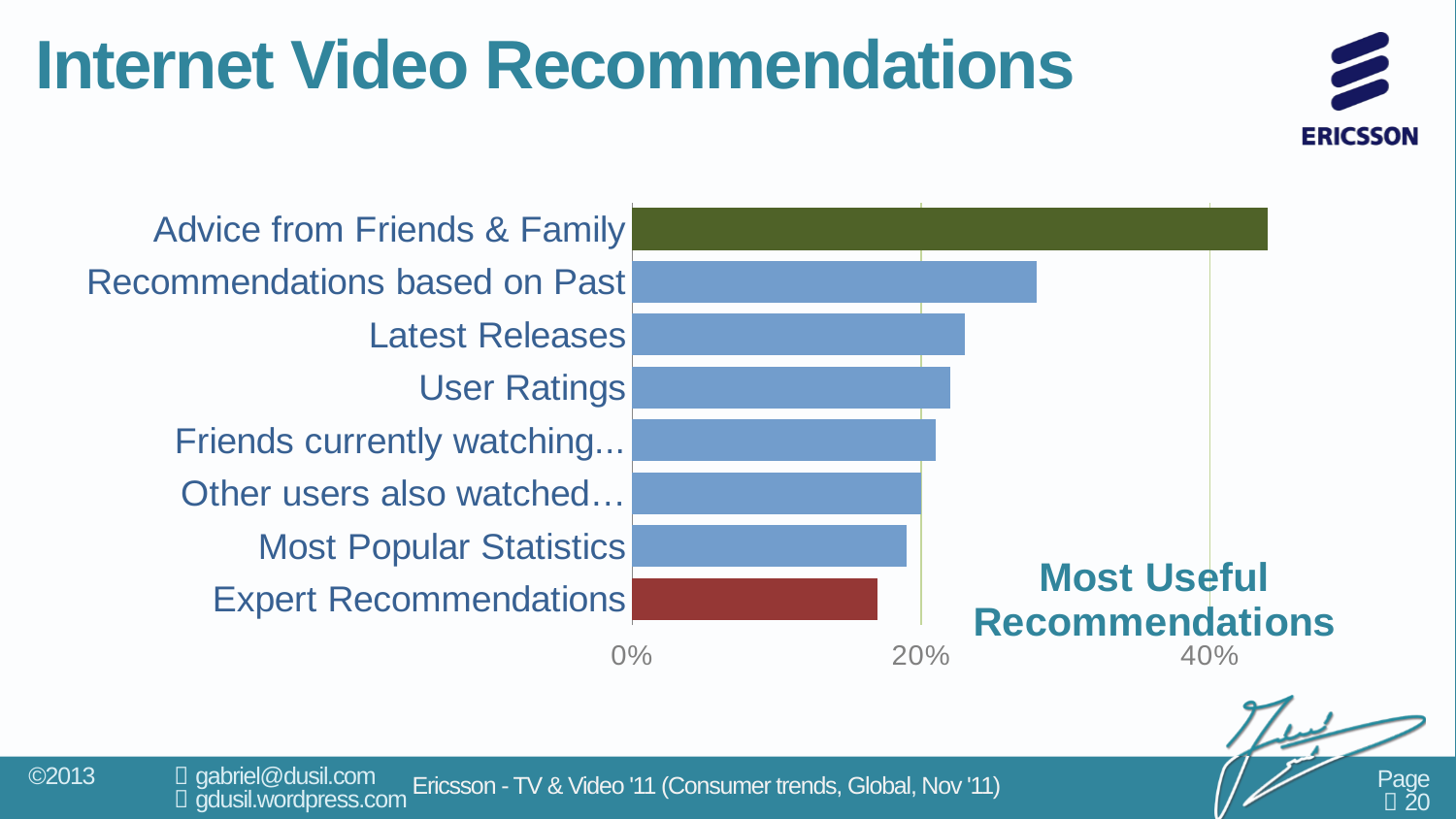
Is the value for Latest Releases greater or less than 20%? greater Which category has the lowest value in the chart? Expert Recommendations Which is larger, the value for Most Popular Statistics or the value for Advice from Friends & Family? Advice from Friends & Family What kind of chart is shown on the slide? bar chart How many categories are plotted in the chart? 8 Is the value for Expert Recommendations greater or less than 20%? less Which is larger, the value for Recommendations based on Past or the value for Latest Releases? Recommendations based on Past Do the bar values increase or decrease going from the top category to the bottom category? decrease What label is printed in large text inside the chart area? Most Useful Recommendations Is the value for Advice from Friends & Family greater or less than 40%? greater Which category has the highest value in the chart? Advice from Friends & Family